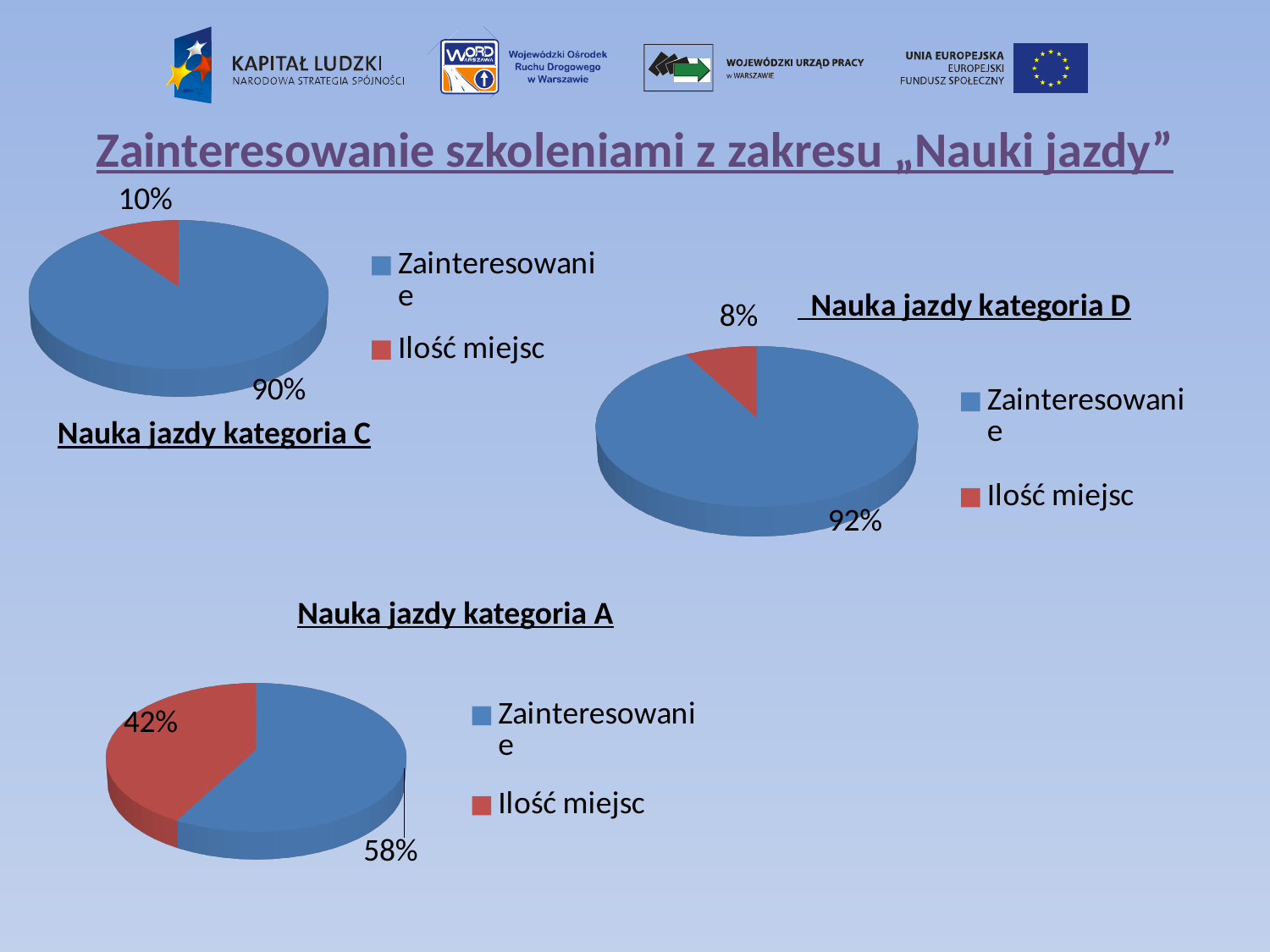
In the 'Nauka jazdy kategoria C' chart, what share of the pie is 'Zainteresowanie'? 90% In the 'Nauka jazdy kategoria D' chart, what share of the pie is 'Ilość miejsc'? 8% In the 'Nauka jazdy kategoria A' chart, what is the difference between the 'Zainteresowanie' and 'Ilość miejsc' shares? 16% In the 'Nauka jazdy kategoria C' chart, what share of the pie is 'Ilość miejsc'? 10% In the 'Nauka jazdy kategoria D' chart, which slice is the smallest? Ilość miejsc What kind of chart is 'Nauka jazdy kategoria C'? Pie chart How many entries does the legend of the 'Nauka jazdy kategoria A' chart list? 2 In the 'Nauka jazdy kategoria A' chart, which slice is larger, 'Zainteresowanie' or 'Ilość miejsc'? Zainteresowanie How many slices does the 'Nauka jazdy kategoria D' pie chart have? 2